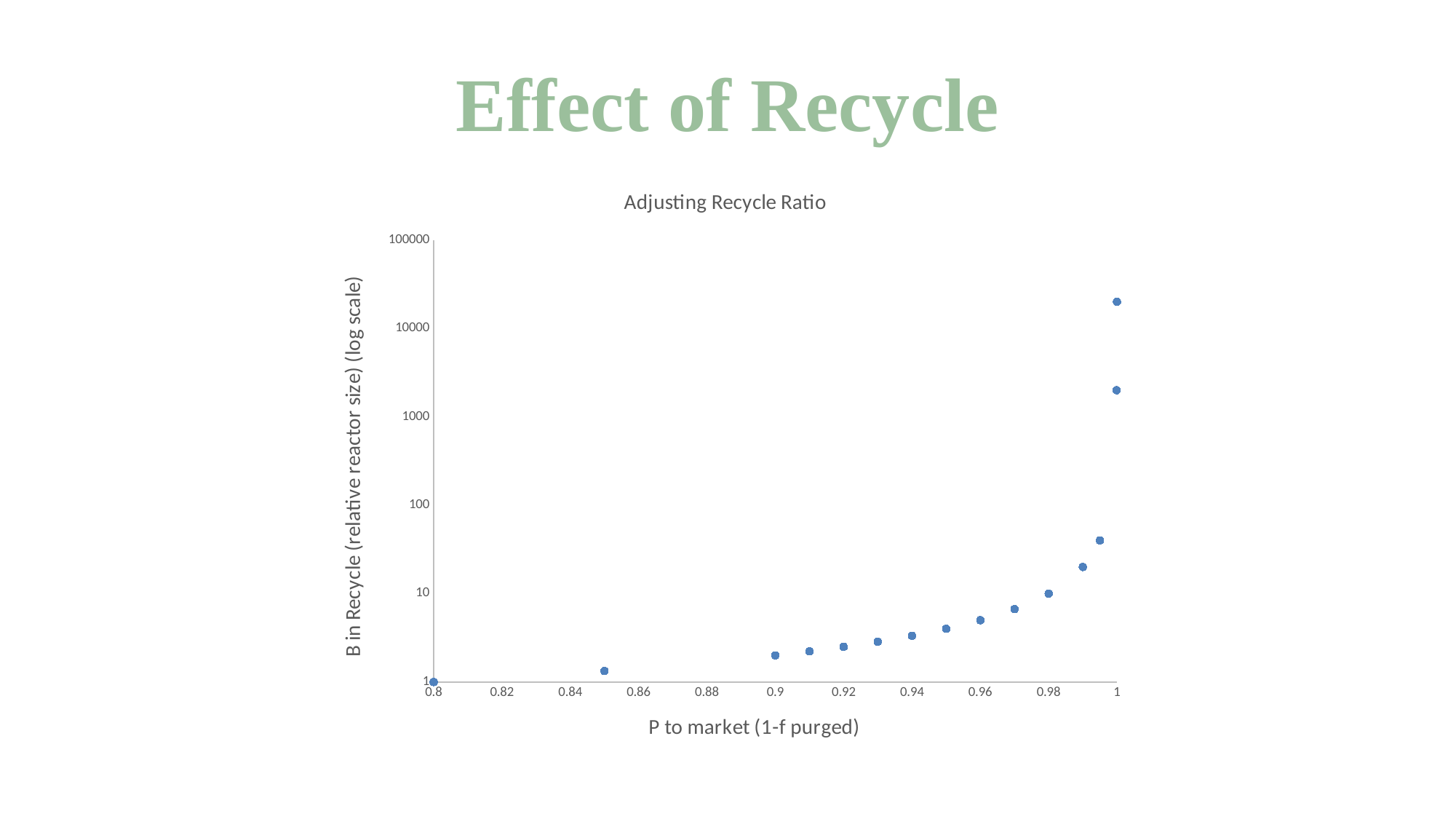
At which x-axis value does the lowest plotted point occur? 0.8 Is the highest plotted value greater or less than 10000? greater What kind of chart is shown on the slide? scatter chart Is the value for P to market = 0.85 greater or less than 10? less Is the value for P to market = 0.99 greater or less than 10? greater At which x-axis value does the highest plotted point occur? 1 Which has the larger value: the point at P to market = 0.95 or the point at P to market = 0.99? 0.99 Do the plotted values rise or fall as P to market increases along the x axis? rise What is the title of the chart? Adjusting Recycle Ratio What is the x-axis title of the chart? P to market (1-f purged)